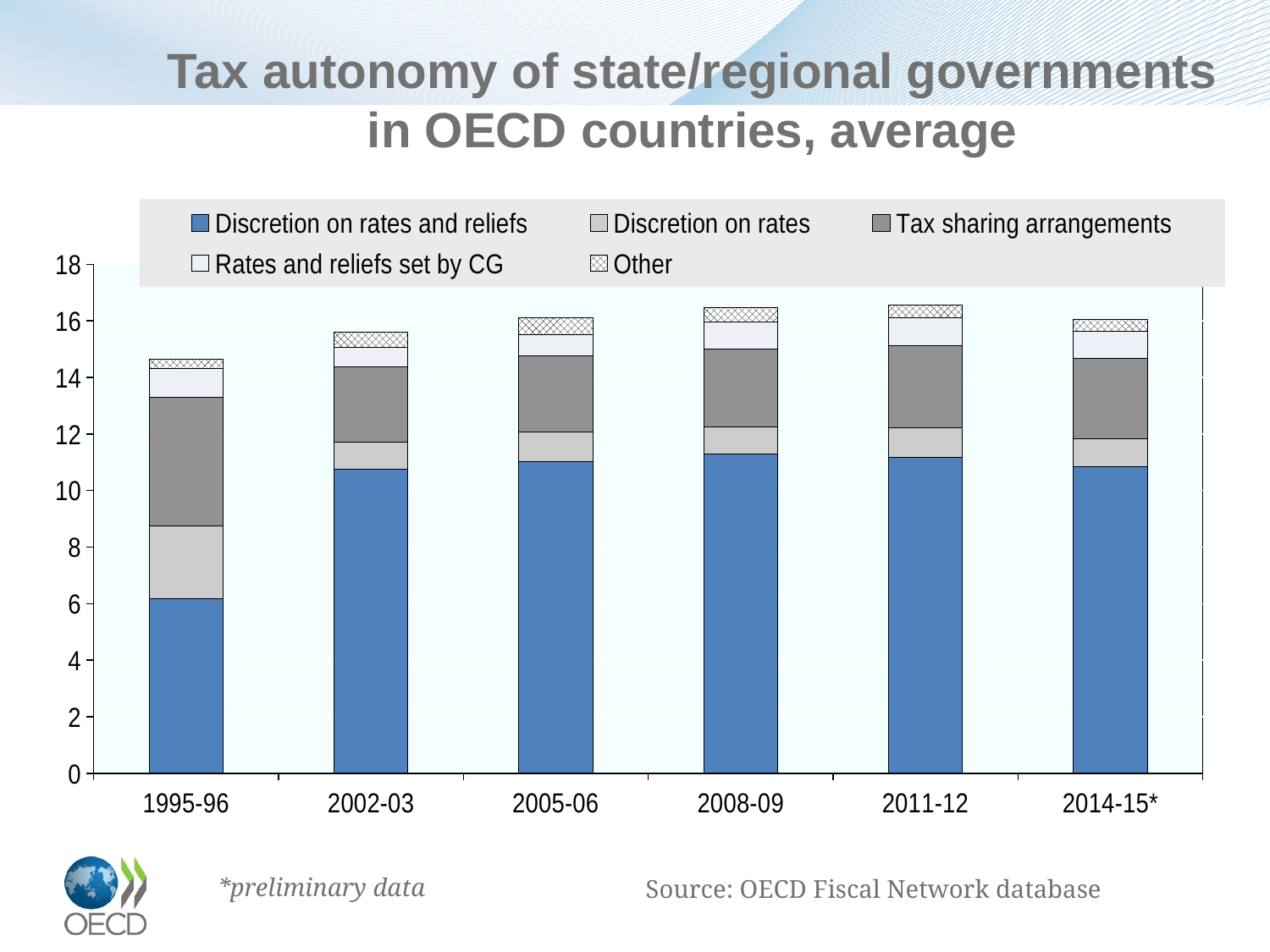
Does the Discretion on rates and reliefs segment rise or fall from 1995-96 to 2008-09? rise What kind of chart is shown on the slide? Stacked bar chart Which period has the larger Tax sharing arrangements segment, 1995-96 or 2002-03? 1995-96 Is the value for Discretion on rates and reliefs in 2002-03 greater or less than 10? greater What is the source cited for the chart? OECD Fiscal Network database Is the value for Discretion on rates and reliefs in 1995-96 greater or less than 8? less Which period has the lowest value for Discretion on rates and reliefs? 1995-96 Which period has the larger Discretion on rates and reliefs segment, 1995-96 or 2002-03? 2002-03 How many time periods are shown on the x axis? 6 Is the total bar height for 2008-09 greater or less than 16? greater Which period has the lowest total bar height? 1995-96 How many series does the legend list? 5